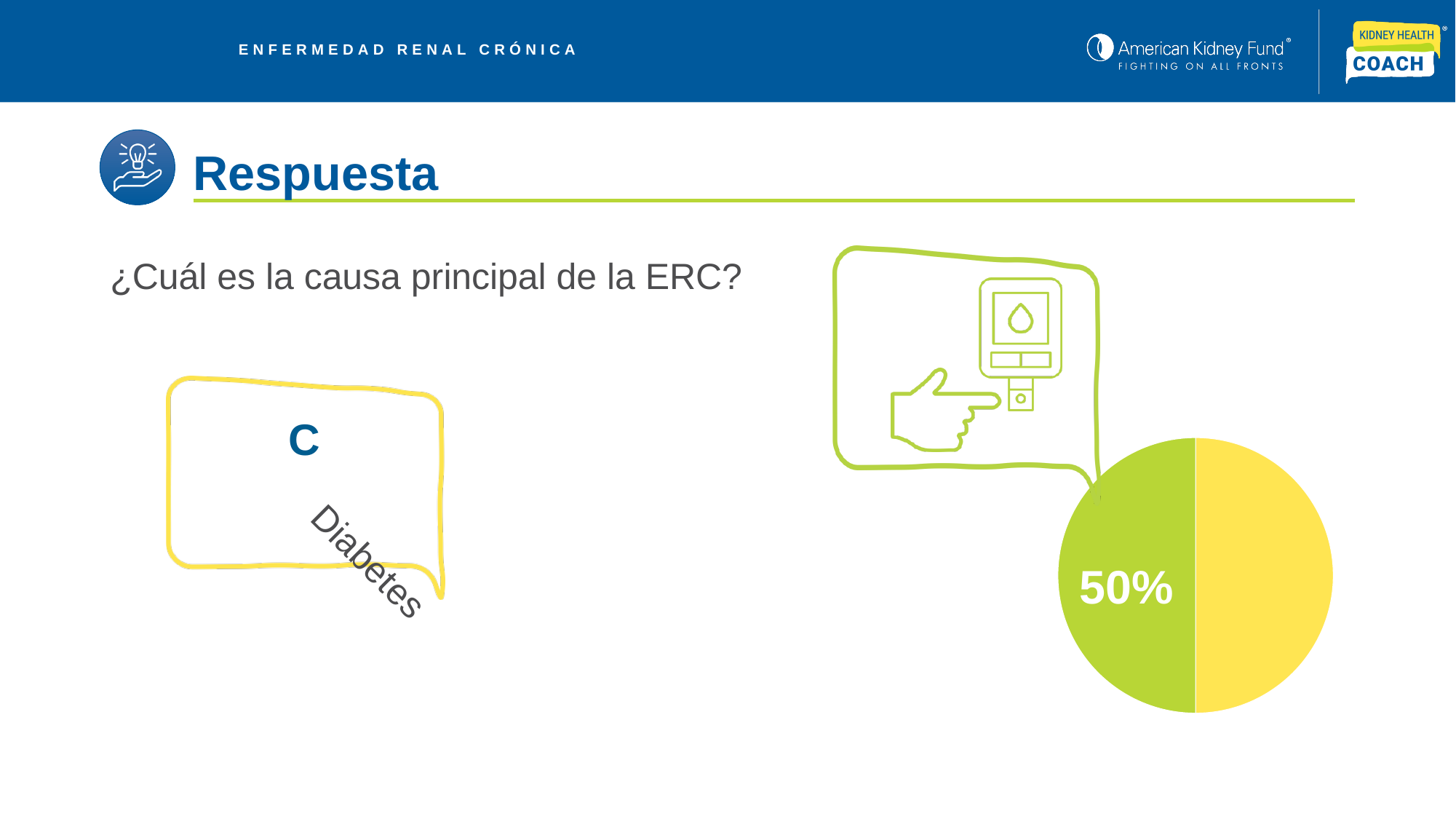
What colour is the unlabeled slice of the pie chart? yellow What colour is the slice of the pie chart that carries the 50% label? green What kind of chart is shown on the slide? pie chart What share of the pie does the green slice represent? 50% What percentage is printed on the green slice of the pie chart? 50% How many slices does the pie chart have? 2